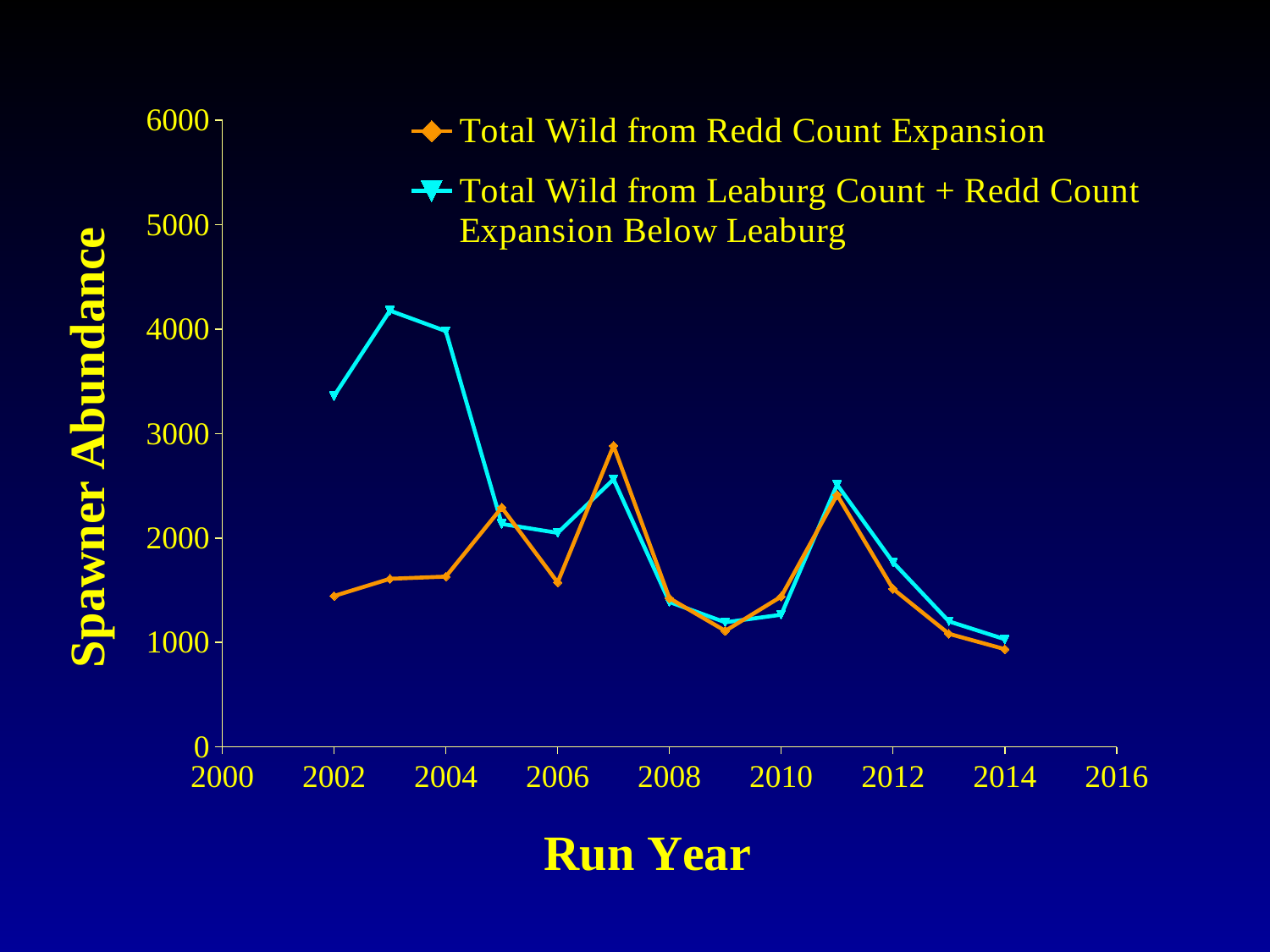
In which run year is the Total Wild from Redd Count Expansion series highest? 2007 In which run year is the Total Wild from Redd Count Expansion series lowest? 2014 Does the Total Wild from Redd Count Expansion series rise or fall from 2011 to 2014? fall Is the 2012 value for Total Wild from Leaburg Count + Redd Count Expansion Below Leaburg greater or less than 2000? less In 2003, which series has the larger value: Total Wild from Redd Count Expansion or Total Wild from Leaburg Count + Redd Count Expansion Below Leaburg? Total Wild from Leaburg Count + Redd Count Expansion Below Leaburg How many series does the legend list? 2 Is the 2002 value for Total Wild from Redd Count Expansion greater or less than 1000? greater How many run years are plotted for the Total Wild from Redd Count Expansion series? 13 What kind of chart is shown on the slide? line chart What is the title of the y axis? Spawner Abundance Is the 2003 value for Total Wild from Leaburg Count + Redd Count Expansion Below Leaburg greater or less than 4000? greater In which run year is the Total Wild from Leaburg Count + Redd Count Expansion Below Leaburg series highest? 2003